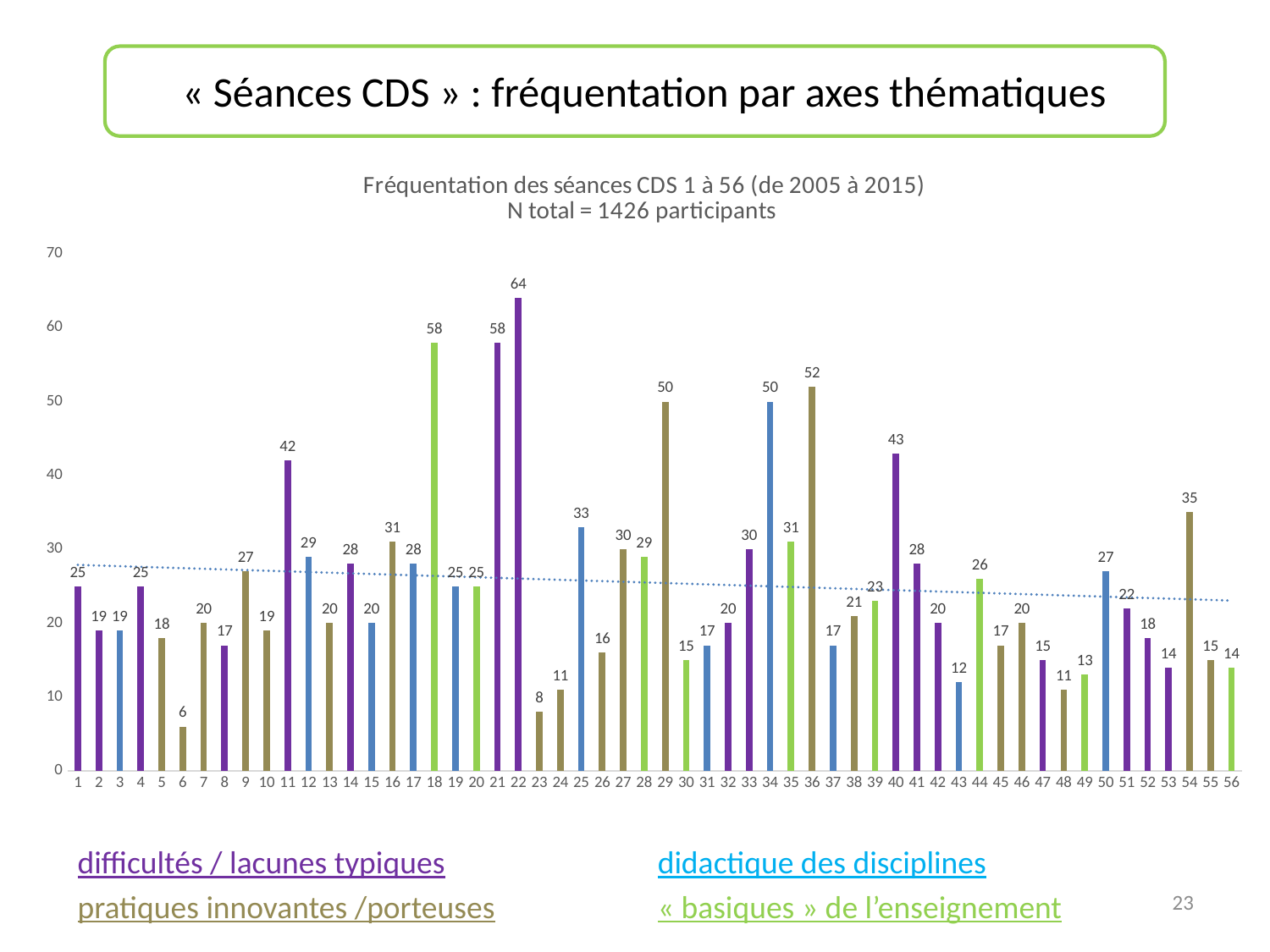
What is the attendance value for session 22? 64 How many sessions (bars) are plotted on the chart? 56 Which session has the highest attendance? 22 What kind of chart is shown on the slide? bar chart Which has higher attendance, session 29 or session 36? session 36 According to the chart title, what is the total number of participants (N total)? 1426 What is the attendance value for session 18? 58 Is the value for session 54 greater or less than 30? greater What is the difference between the attendance of session 22 and session 21? 6 Does the dotted trend line rise or fall from session 1 to session 56? fall Which session has the lowest attendance? 6 What is the attendance value for session 36? 52